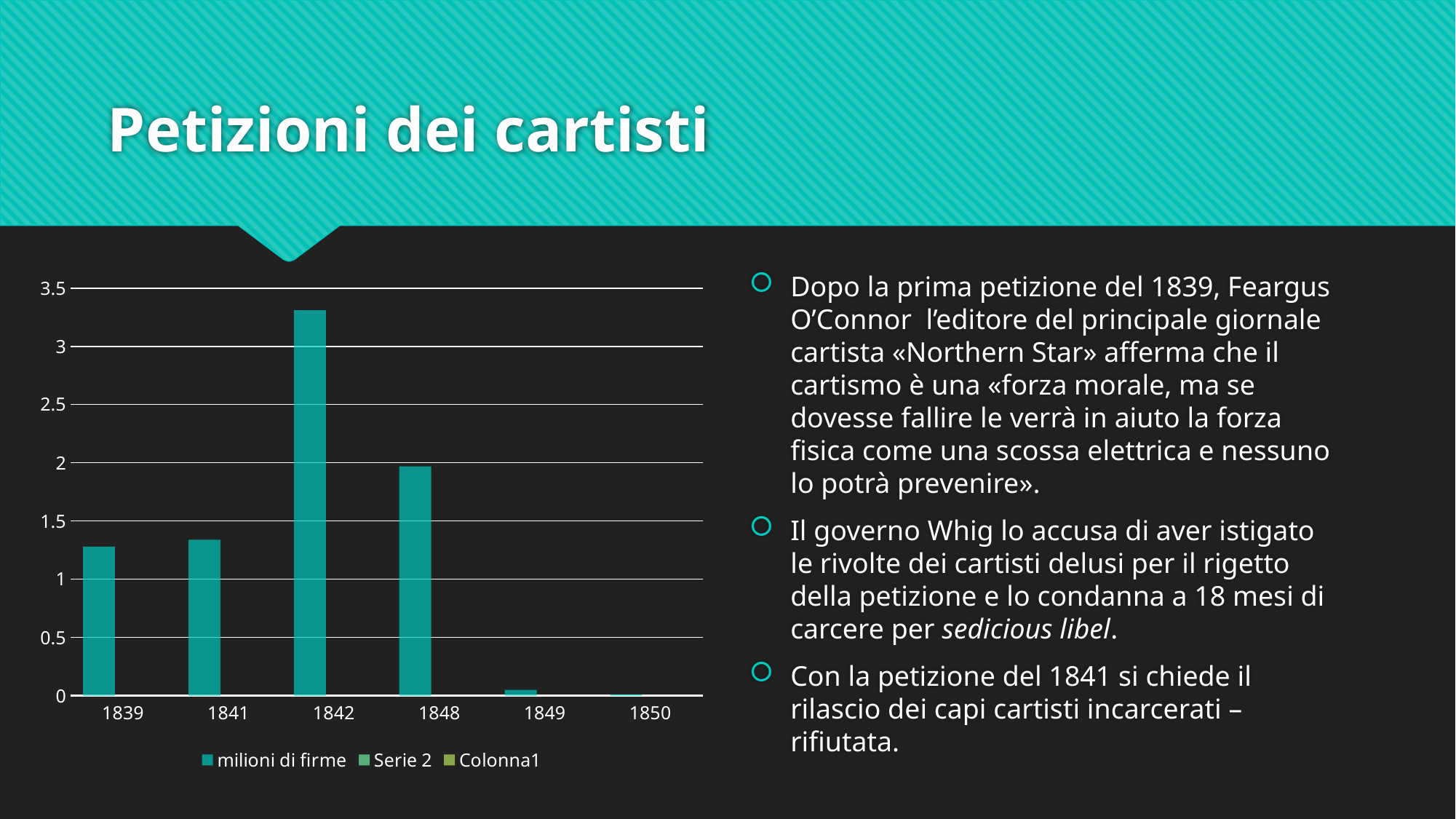
Which year has the highest bar in the chart? 1842 Which is larger, the value for 1848 or the value for 1839? 1848 Which is larger, the value for 1842 or the value for 1848? 1842 Do the values rise or fall from 1842 to 1850? fall Is the value for 1839 greater or less than 1? greater What is the first entry in the chart legend? milioni di firme How many years are shown on the x axis of the chart? 6 Is the value for 1842 greater or less than 3? greater What kind of chart is shown on the slide? bar chart How many series does the chart legend list? 3 Is the value for 1849 greater or less than 0.5? less